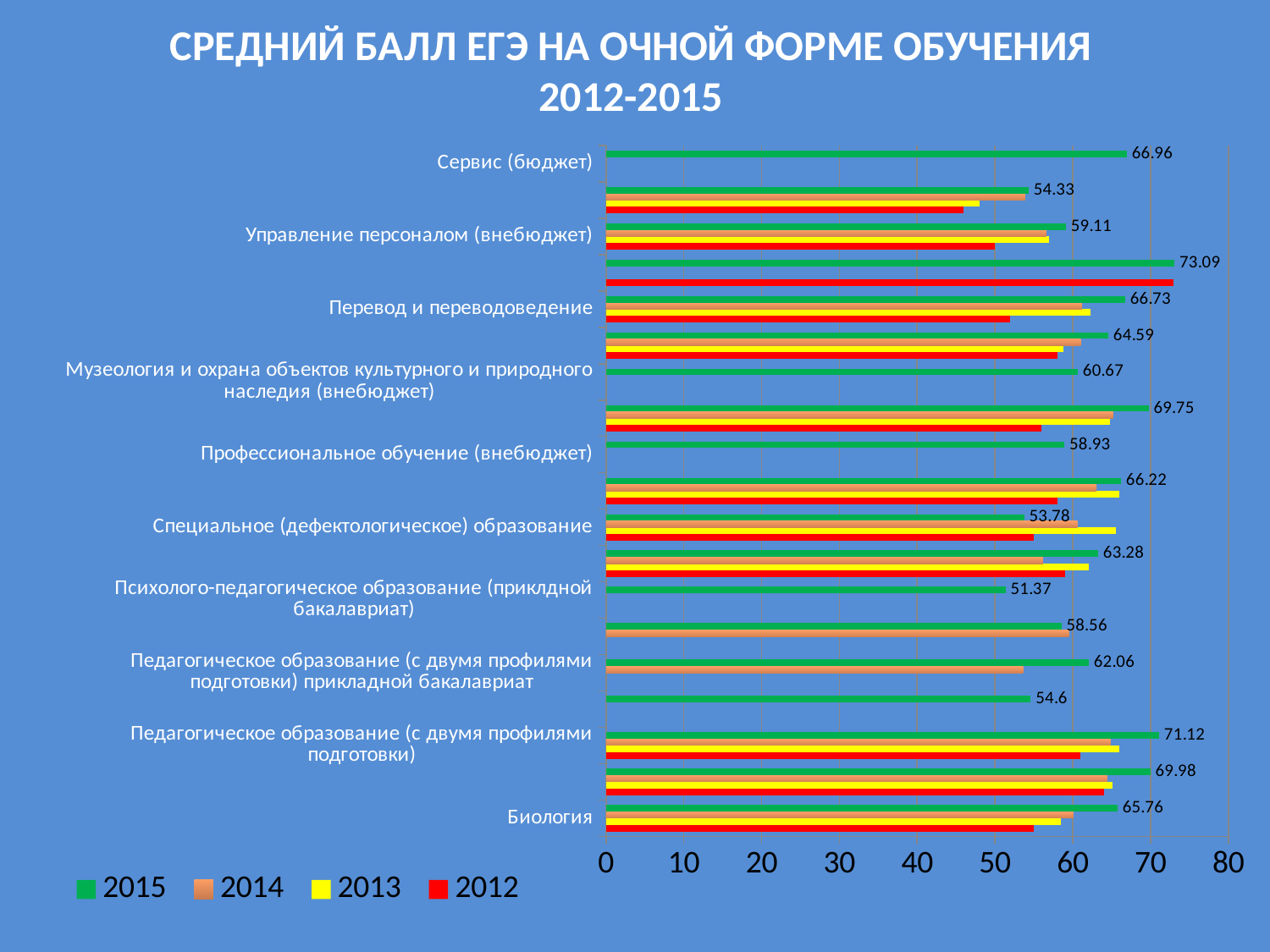
What kind of chart is shown on the slide? bar chart Which has the larger 2015 value: Перевод и переводоведение or Музеология и охрана объектов культурного и природного наследия (внебюджет)? Перевод и переводоведение Is the 2012 value for Биология greater or less than 60? less What is the difference between the 2015 values for Сервис (бюджет) and Биология? 1.2 Which colour represents 2012 in the legend? red What is the 2015 value for Психолого-педагогическое образование (прикладной бакалавриат)? 51.37 What is the 2015 value for Перевод и переводоведение? 66.73 Which labeled category has the lowest 2015 value? Психолого-педагогическое образование (прикладной бакалавриат) What is the 2015 value for Биология? 65.76 What is the 2015 value for Сервис (бюджет)? 66.96 What is the 2015 value for Педагогическое образование (с двумя профилями подготовки)? 71.12 How many series does the legend list? 4